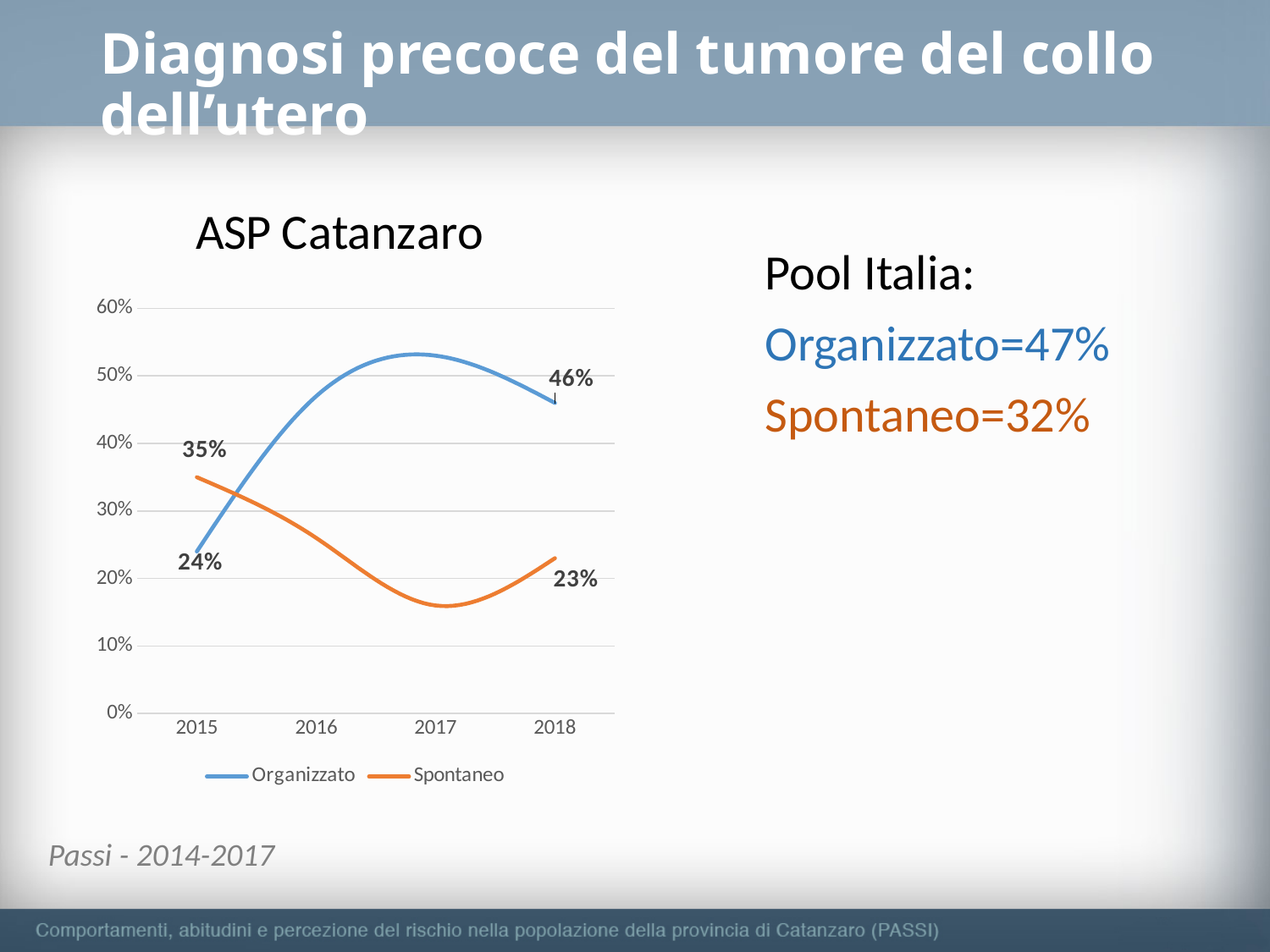
How many series does the legend list? 2 Is the value for Organizzato in 2017 greater or less than 50%? greater What kind of chart is shown on the slide? Line chart What is the value for Organizzato in 2018? 46% By how many percentage points did Organizzato change from 2015 to 2018? 22 percentage points What is the value for Spontaneo in 2015? 35% What is the value for Spontaneo in 2018? 23% By how many percentage points did Spontaneo fall from 2015 to 2018? 12 percentage points In 2018, which series has the higher value, Organizzato or Spontaneo? Organizzato Is the value for Spontaneo in 2017 greater or less than 20%? less What is the value for Organizzato in 2015? 24% In 2015, which series has the higher value, Organizzato or Spontaneo? Spontaneo